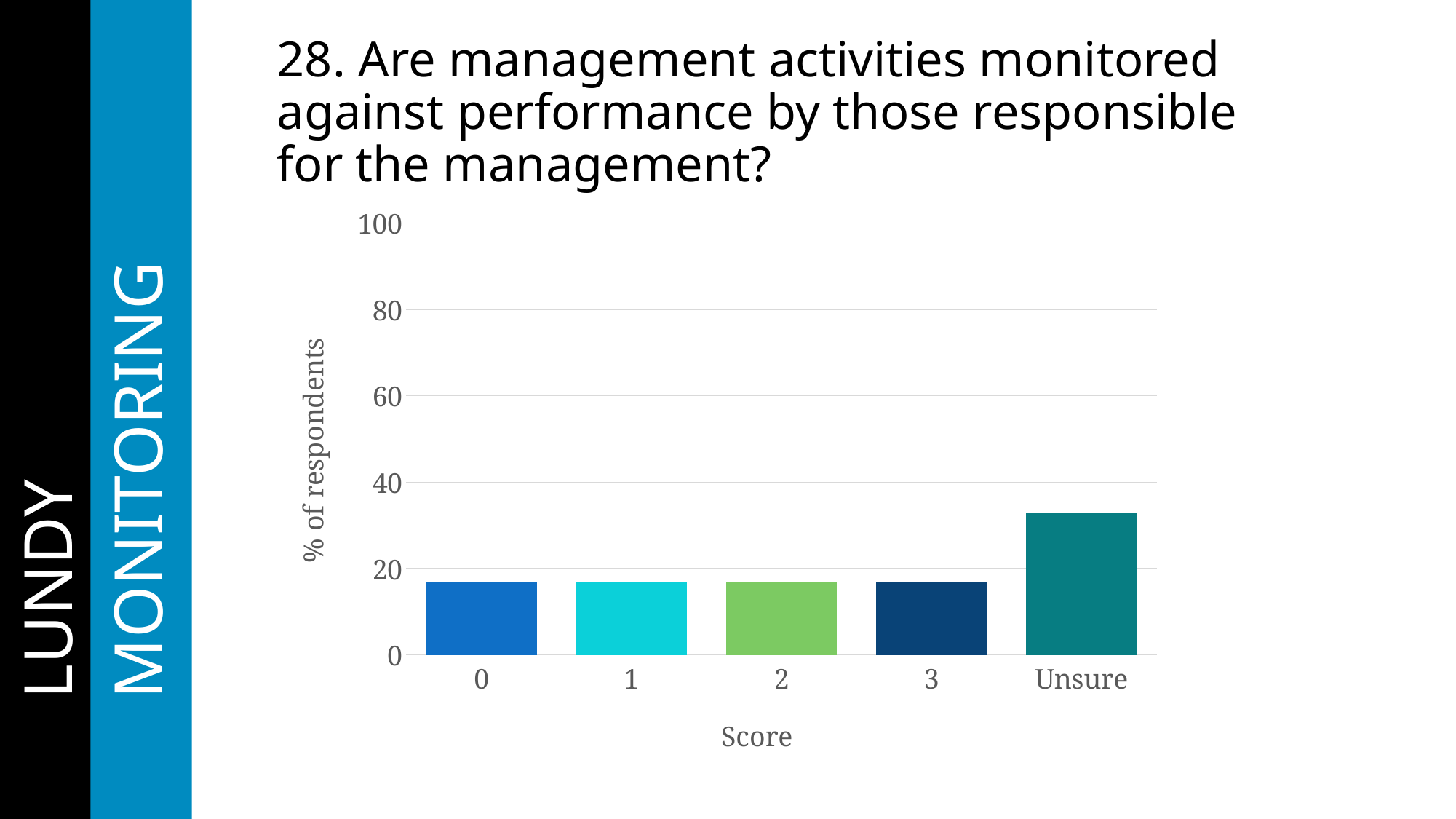
What is the label of the y axis of the chart? % of respondents Is the value for Unsure greater or less than 40? less Which is larger, the value for Unsure or the value for score 1? Unsure How many categories are shown on the x axis of the chart? 5 Which is larger, the value for score 2 or the value for Unsure? Unsure What is the label of the x axis of the chart? Score Which category has the highest percentage of respondents? Unsure Is the value for score 0 greater or less than 20? less What kind of chart is shown on the slide? bar chart Is the value for score 3 greater or less than 40? less